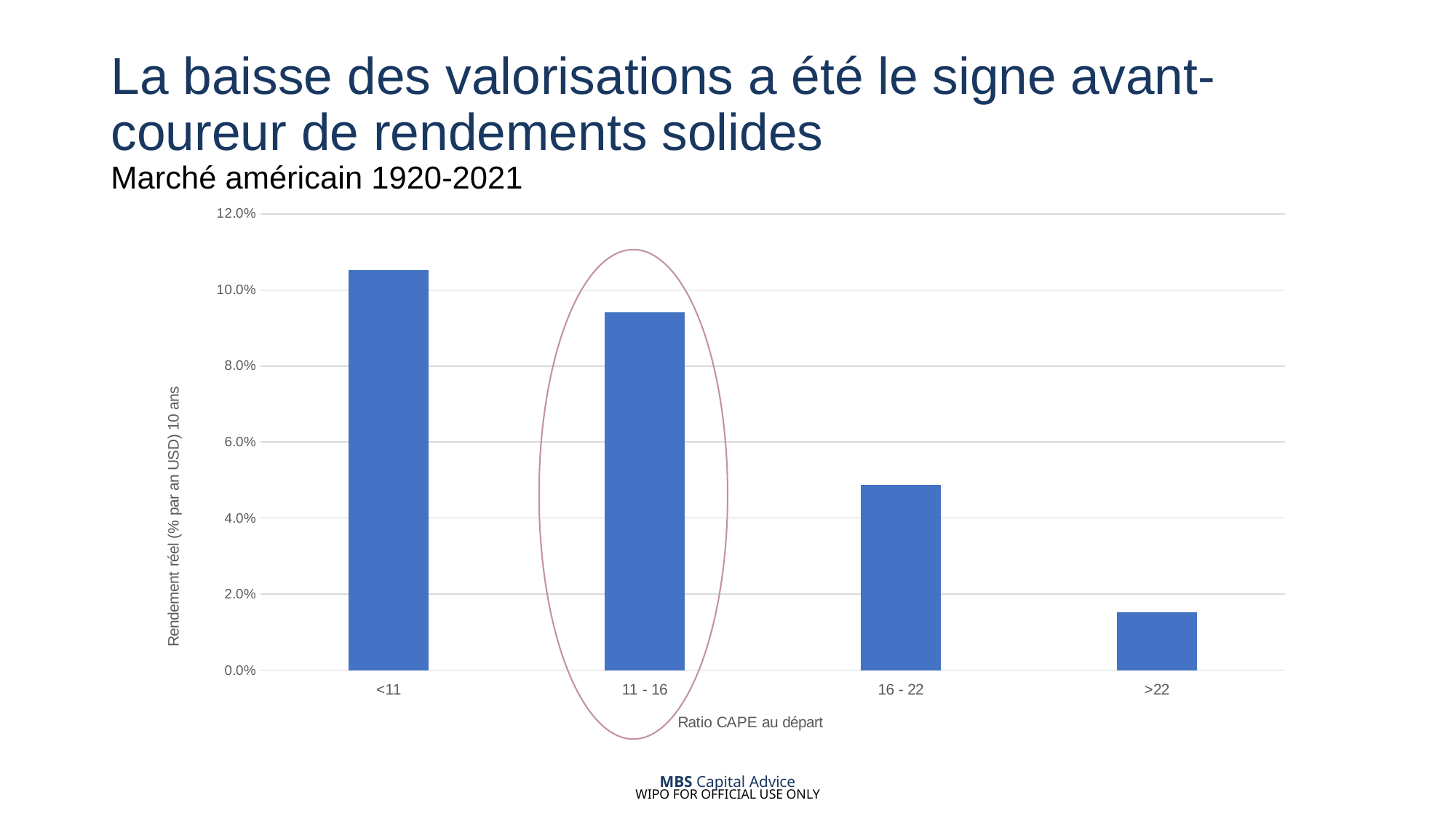
Which starting CAPE ratio category has the lowest real return? >22 Is the value for the <11 category greater or less than 10.0%? greater Is the value for the 11 - 16 category greater or less than 10.0%? less What is the label of the x axis? Ratio CAPE au départ How many CAPE ratio categories are plotted on the x axis? 4 Which has a higher real return, the 11 - 16 category or the 16 - 22 category? 11 - 16 Which starting CAPE ratio category has the highest real return? <11 Do the bar values rise or fall as the starting CAPE ratio increases along the x axis? fall What kind of chart is shown on the slide? bar chart Is the value for the 16 - 22 category greater or less than 6.0%? less Which category's bar is circled on the chart? 11 - 16